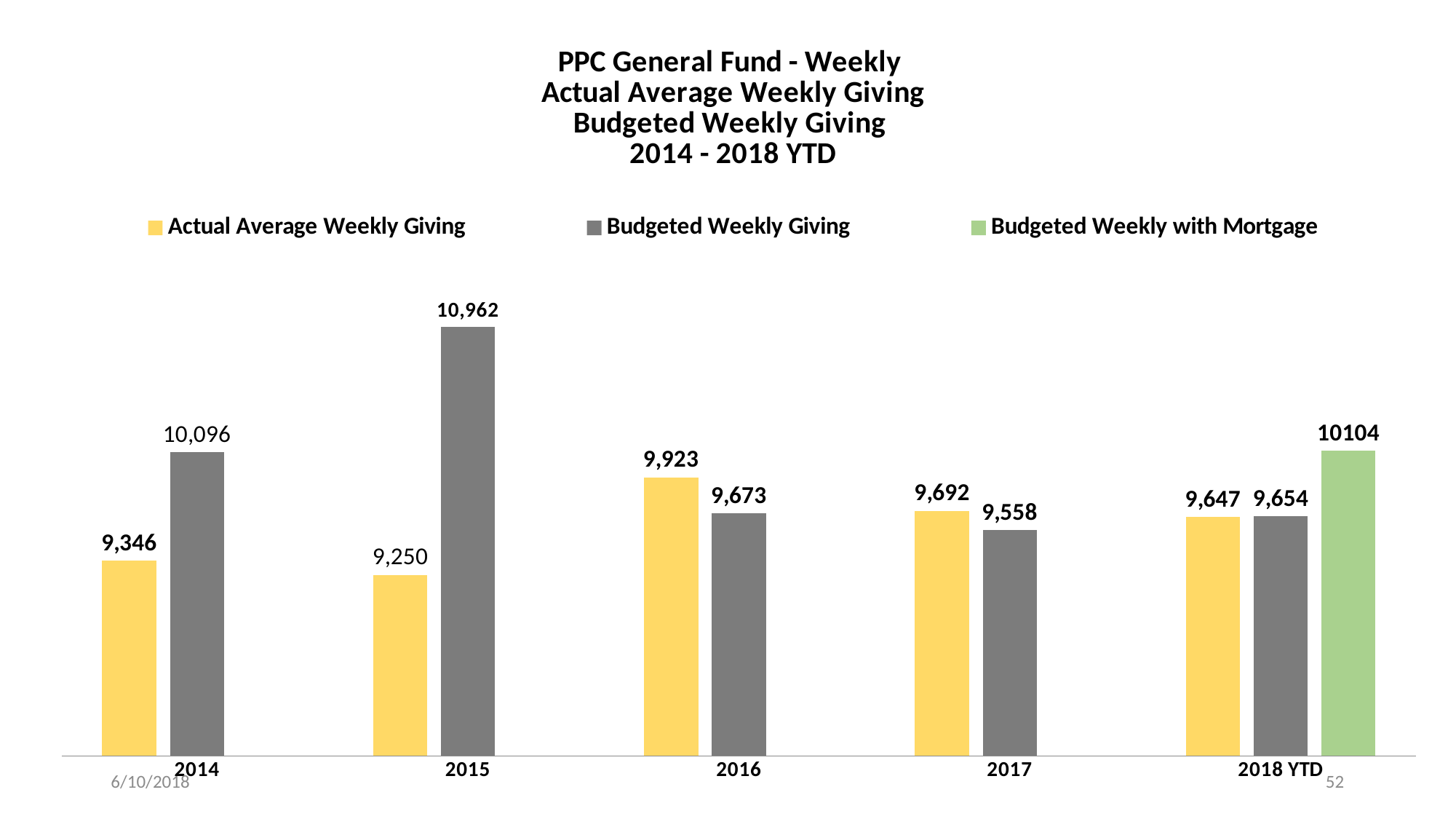
In 2017, which is larger: Actual Average Weekly Giving or Budgeted Weekly Giving? Actual Average Weekly Giving What kind of chart is shown on the slide? Bar chart What is the difference between Budgeted Weekly Giving and Actual Average Weekly Giving in 2015? 1,712 What is the Actual Average Weekly Giving for 2016? 9,923 Which year has the lowest Actual Average Weekly Giving? 2015 Does Budgeted Weekly Giving rise or fall from 2015 to 2017? Fall How many years are shown on the x axis? 5 What is the Budgeted Weekly Giving for 2015? 10,962 Which year has the highest Budgeted Weekly Giving? 2015 How many series does the legend list? 3 What is the value of Budgeted Weekly with Mortgage for 2018 YTD? 10104 What is the difference between Budgeted Weekly Giving and Actual Average Weekly Giving in 2018 YTD? 7